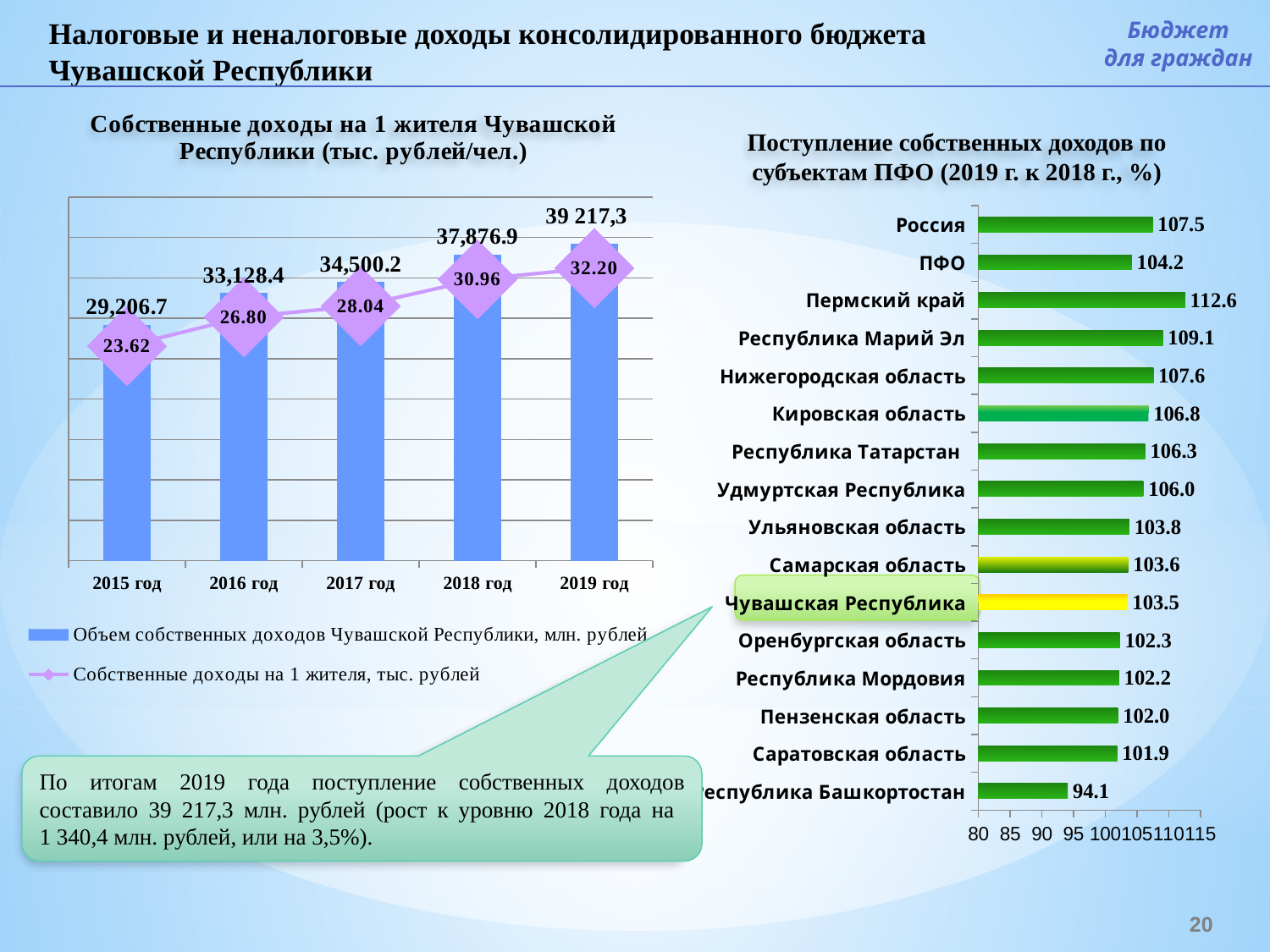
On the right chart, which region has the lowest value? Республика Башкортостан On the right chart, which region has the highest value? Пермский край On the left chart, what is the value of the bar for 2019 год? 39 217,3 On the right chart, what is the value for Чувашская Республика? 103.5 What kind of chart is the right chart? bar chart On the right chart, which is larger: the value for Россия or the value for ПФО? Россия On the right chart, how many categories are shown? 16 On the left chart, what is the value of the bar for 2017 год? 34,500.2 On the left chart, what is the value of the line marker for 2015 год? 23.62 On the left chart, do the bar values rise or fall from 2015 год to 2019 год? rise On the left chart, what is the difference between the line values for 2019 год and 2018 год? 1.24 On the left chart, how many series does the legend list? 2